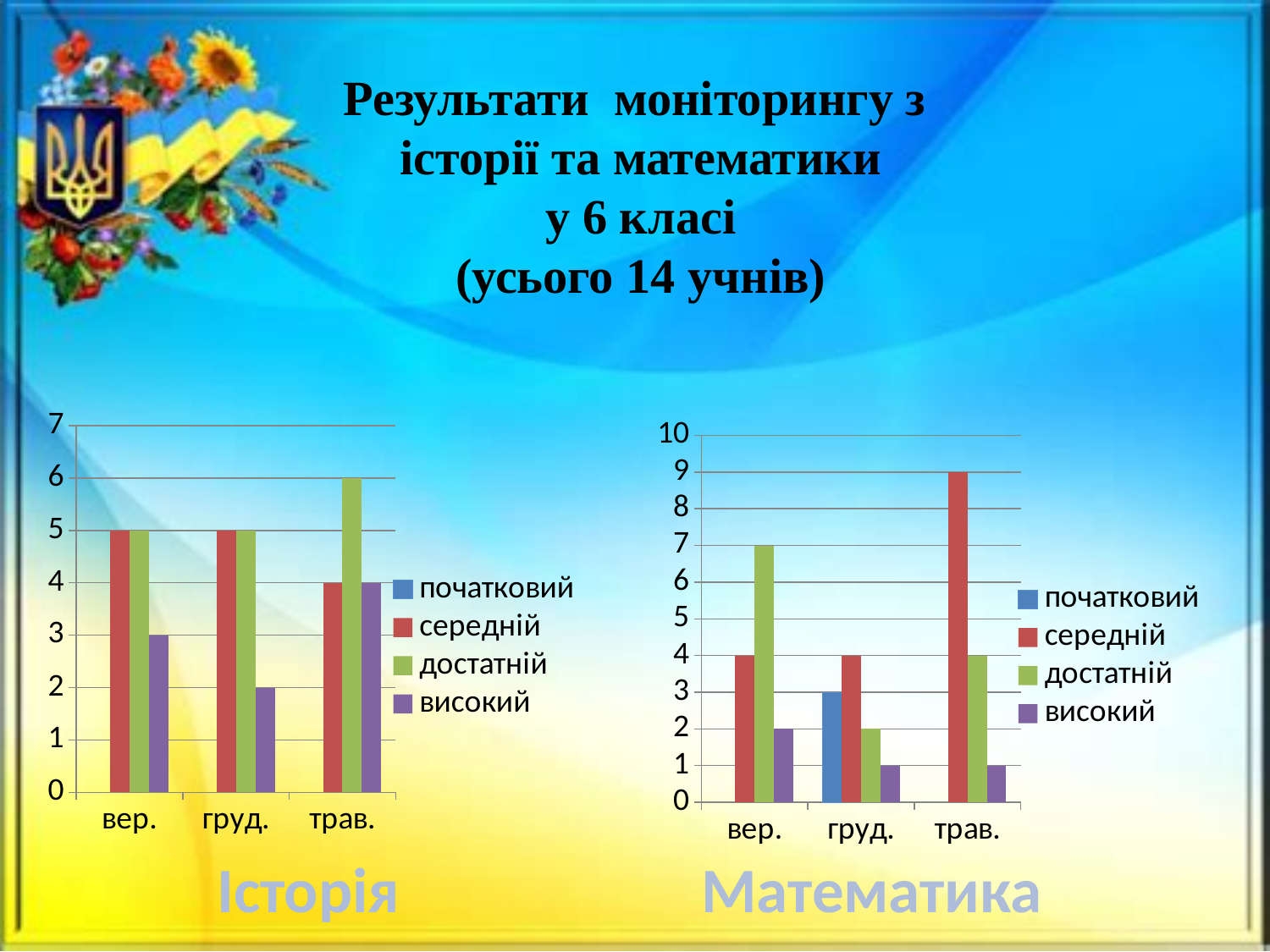
How many series does the legend of the Математика chart list? 4 In the Історія chart, which category has the lowest високий value? груд. In the Математика chart, is the value of середній for трав. greater or less than 8? greater In the Математика chart, what is the value of середній for трав.? 9 What kind of chart is the Історія chart on the left? bar chart How many categories are shown on the x axis of the Історія chart? 3 In the Історія chart, which is larger for трав.: середній or достатній? достатній In the Історія chart, what is the value of високий for вер.? 3 In the Математика chart, which category has the highest середній value? трав. In the Математика chart, what is the value of достатній for вер.? 7 In the Історія chart, what is the value of достатній for трав.? 6 In the Математика chart, which category has a visible початковий bar? груд.